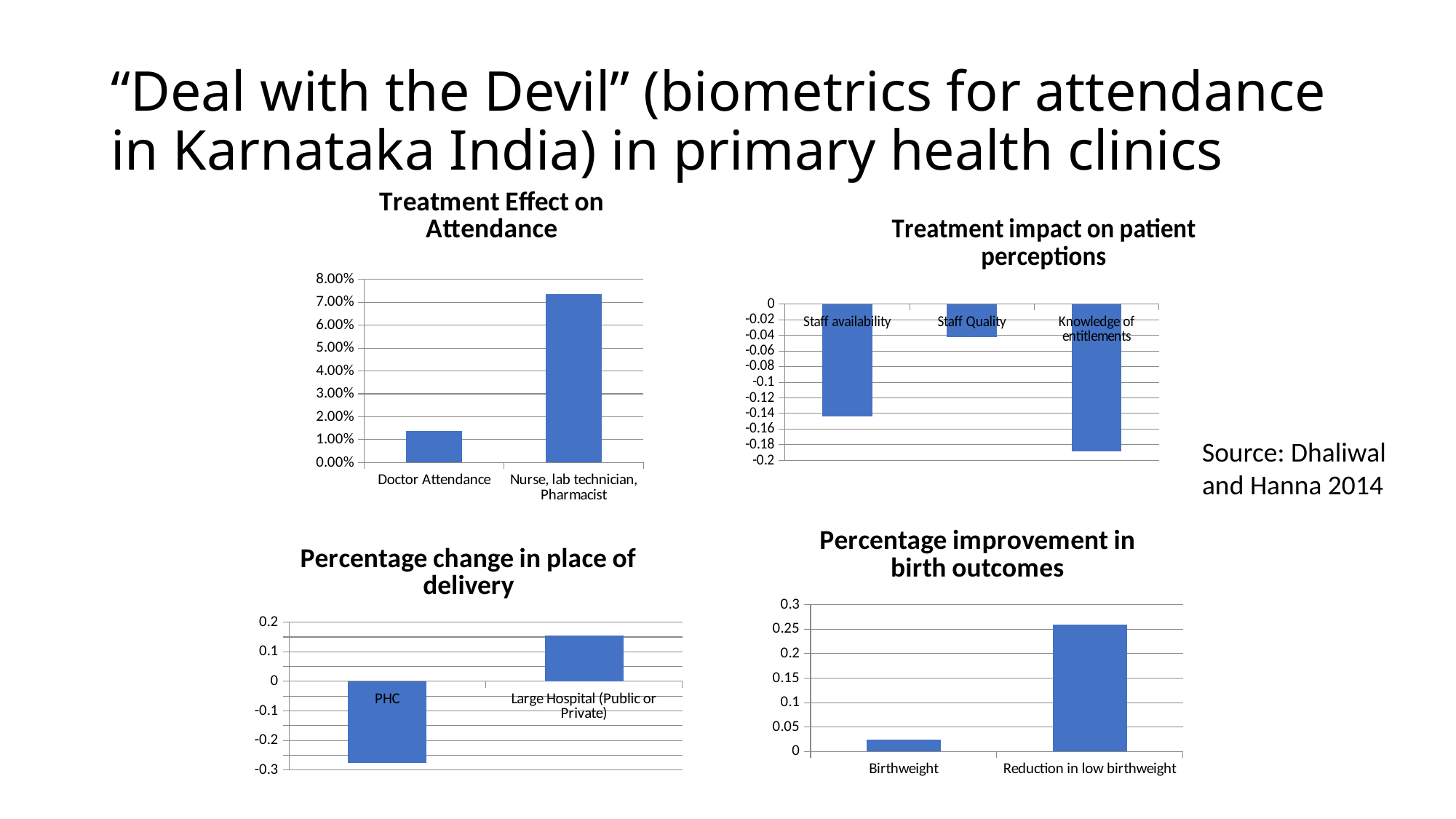
In the 'Treatment impact on patient perceptions' chart, which category has the lowest (most negative) value? Knowledge of entitlements What type of chart is the 'Percentage improvement in birth outcomes' chart? bar chart In the 'Treatment impact on patient perceptions' chart, is the value for Staff availability greater or less than -0.1? less In the 'Percentage improvement in birth outcomes' chart, which category has the higher value? Reduction in low birthweight In the 'Percentage change in place of delivery' chart, is the value for Large Hospital (Public or Private) greater or less than 0.1? greater In the 'Treatment impact on patient perceptions' chart, which category is closest to zero? Staff Quality How many categories are shown in the 'Treatment impact on patient perceptions' chart? 3 In the 'Treatment Effect on Attendance' chart, is the value for Nurse, lab technician, Pharmacist greater or less than 7.00%? greater In the 'Treatment Effect on Attendance' chart, which category has the higher value? Nurse, lab technician, Pharmacist In the 'Percentage change in place of delivery' chart, which category has a negative value? PHC